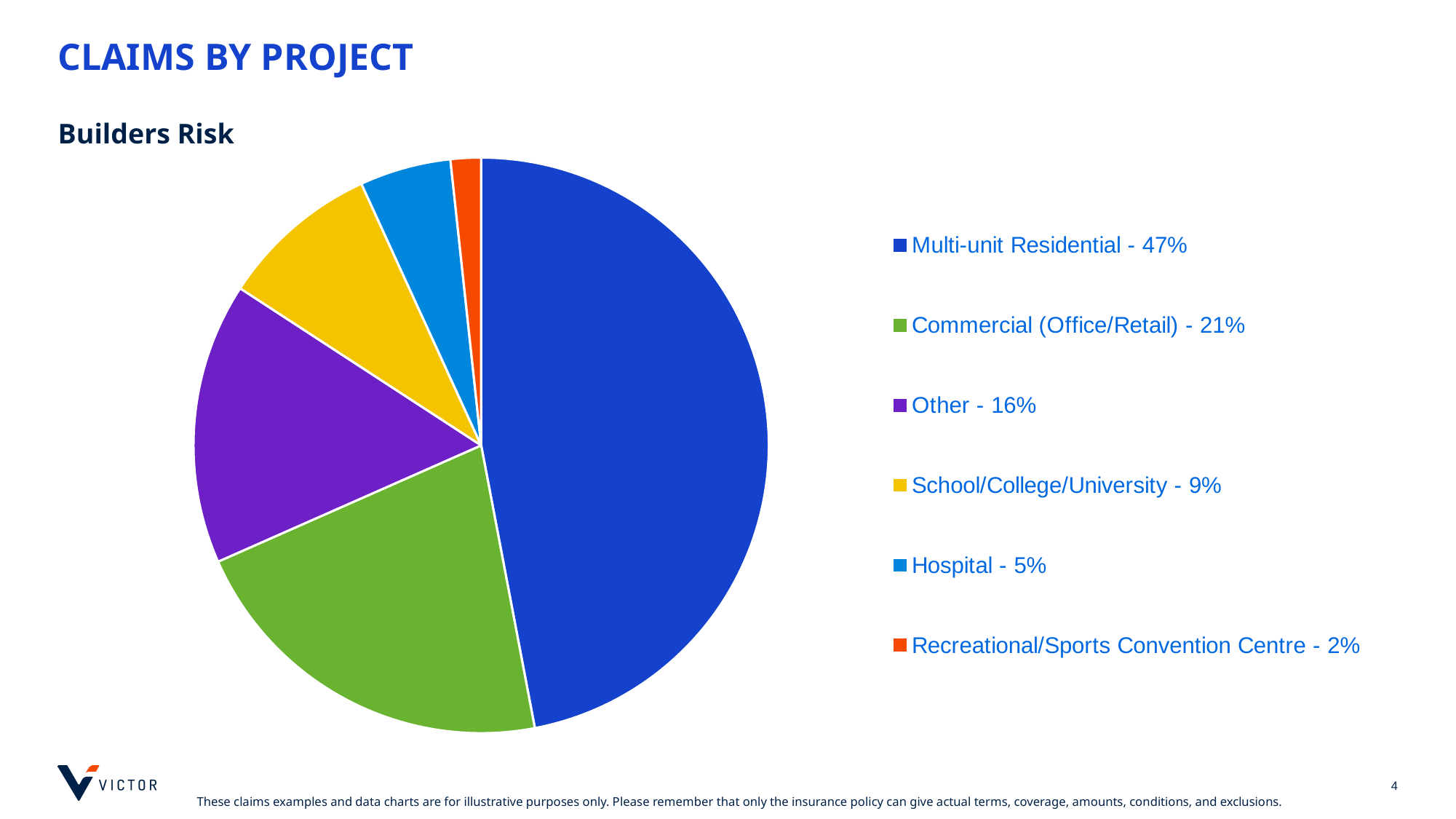
What colour is the slice for Other? Purple Which project type has the smallest share of claims? Recreational/Sports Convention Centre What percentage of claims is Commercial (Office/Retail)? 21% What kind of chart is shown on the slide? Pie chart Which project type has the largest share of claims? Multi-unit Residential What share of Builders Risk claims is Multi-unit Residential? 47% What is the value for School/College/University? 9% What percentage of claims is Hospital? 5% How many categories does the pie chart show? 6 What is the difference in percentage points between Multi-unit Residential and Commercial (Office/Retail)? 26 Which is larger, Other or School/College/University? Other What is the combined share of Hospital and Recreational/Sports Convention Centre? 7%